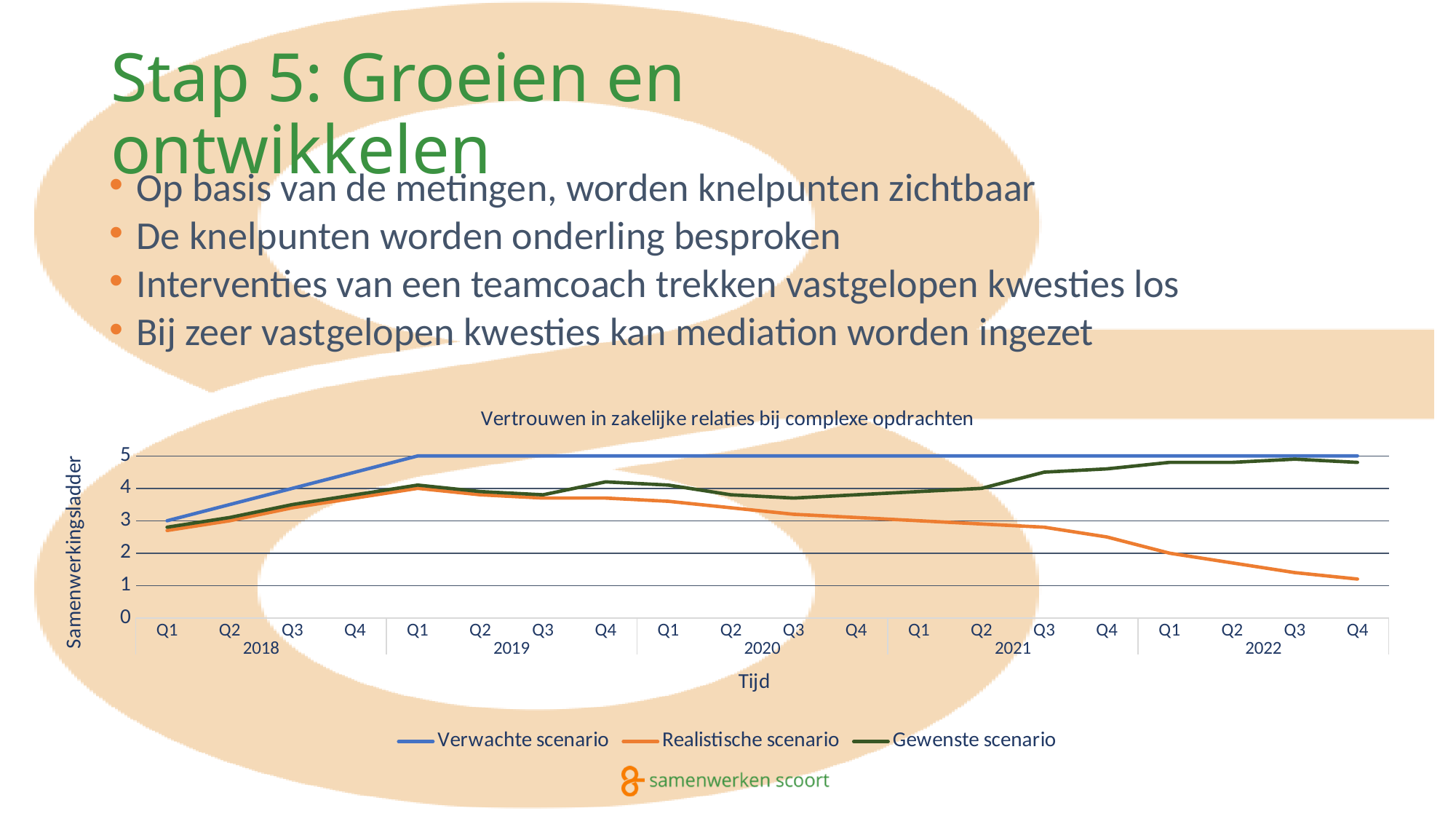
What is the title of the chart? Vertrouwen in zakelijke relaties bij complexe opdrachten What is the label of the y axis of the chart? Samenwerkingsladder In Q4 2022, which is larger: the Gewenste scenario or the Realistische scenario? Gewenste scenario Is the value of the Gewenste scenario in Q3 2021 greater or less than 4? greater What kind of chart is shown on the slide? line chart What is the value of the Verwachte scenario in Q1 2019? 5 Which series has the lowest value in Q4 2022? Realistische scenario Is the value of the Realistische scenario in Q4 2022 greater or less than 2? less What is the value of the Verwachte scenario in Q4 2022? 5 How many quarterly points are plotted along the x axis of the chart? 20 How many series does the legend of the chart list? 3 Does the Realistische scenario rise or fall from Q1 2021 to Q4 2022? fall